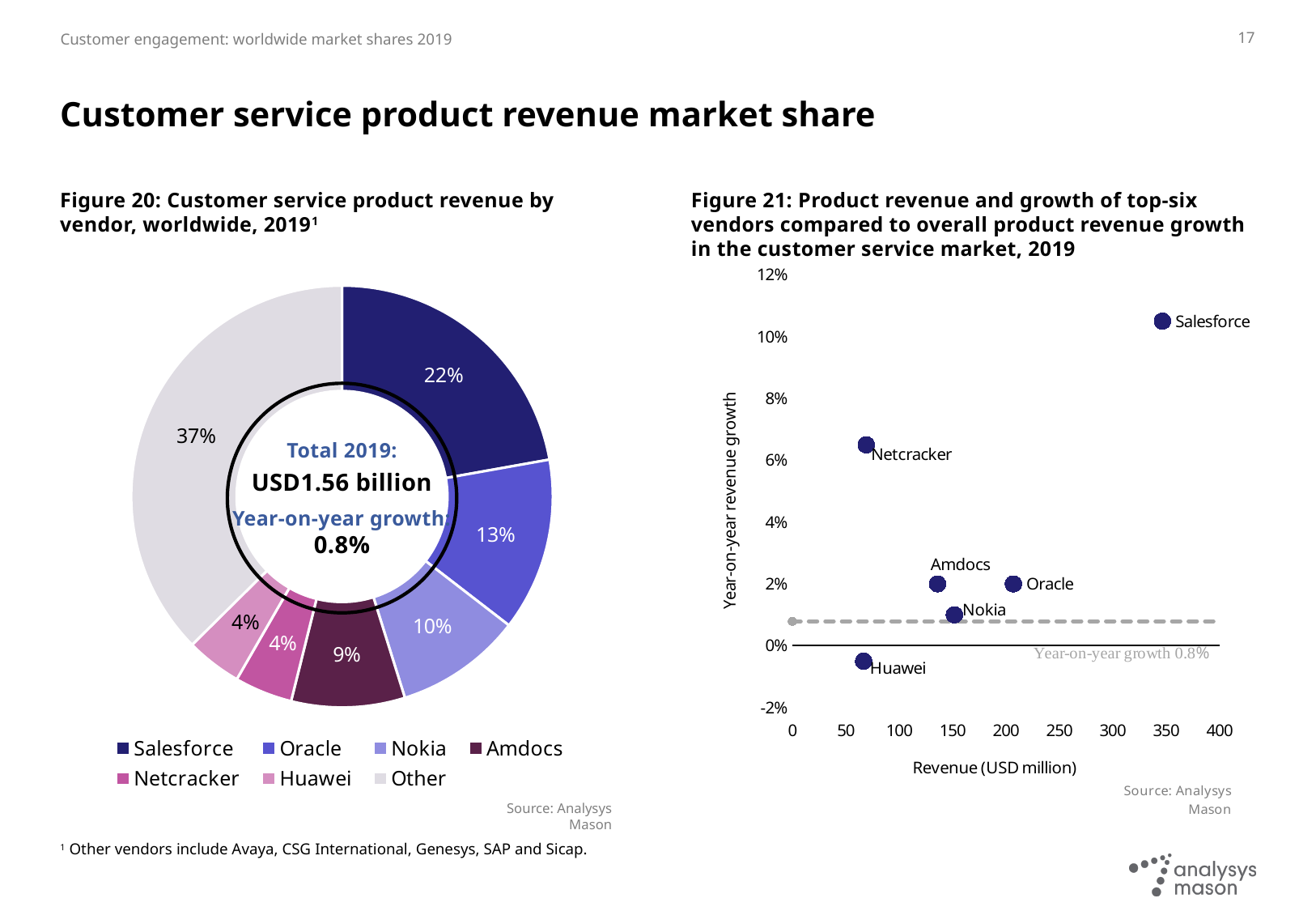
In Figure 20, what share does Nokia hold? 10% In Figure 20, how many categories does the legend list? 7 In Figure 21, which vendor has the highest year-on-year revenue growth? Salesforce In Figure 21, which vendor has the larger revenue, Oracle or Amdocs? Oracle What kind of chart is Figure 20? Pie (donut) chart In Figure 20, which category has the largest share of the donut? Other In Figure 20, what total 2019 revenue is shown in the centre of the donut? USD1.56 billion In Figure 20, what share of customer service product revenue does Salesforce hold? 22% In Figure 20, how many percentage points larger is Salesforce's share than Oracle's? 9 percentage points In Figure 21, which vendor has the lowest year-on-year revenue growth? Huawei What kind of chart is Figure 21? Scatter chart In Figure 21, is Salesforce's revenue greater or less than 300 USD million? greater